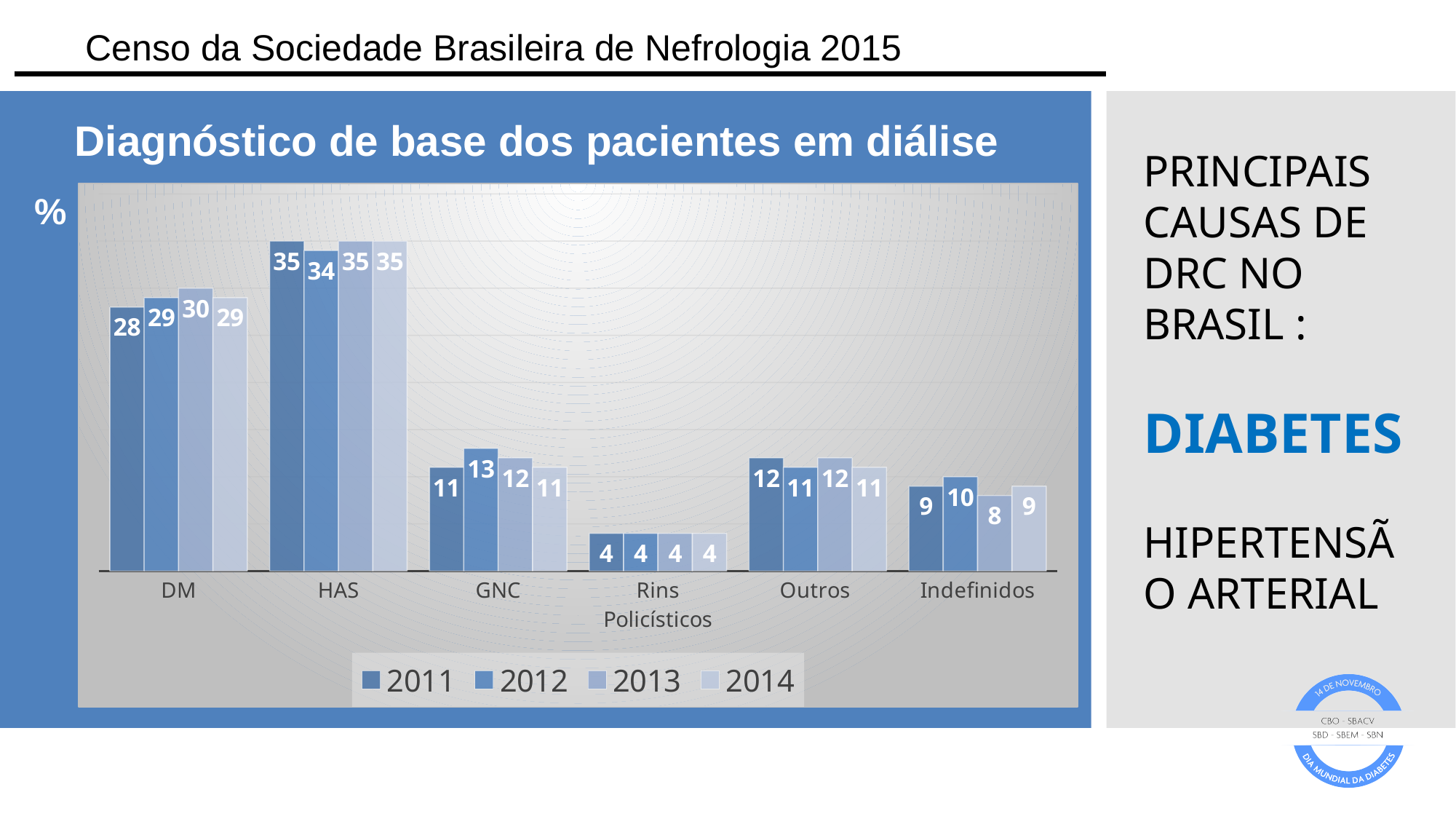
Which is larger in 2012: the value for Outros or the value for Indefinidos? Outros What kind of chart is shown? Bar chart Which category has the lowest value in 2014? Rins Policísticos How many series does the legend list? 4 What is the value for HAS in 2012? 34 What is the value for DM in 2011? 28 What is the value for Indefinidos in 2013? 8 What is the difference between the HAS and DM values in 2011? 7 Which category has the highest value in 2013? HAS What is the value for GNC in 2012? 13 How many categories are shown on the x axis? 6 What is the title of the chart? Diagnóstico de base dos pacientes em diálise